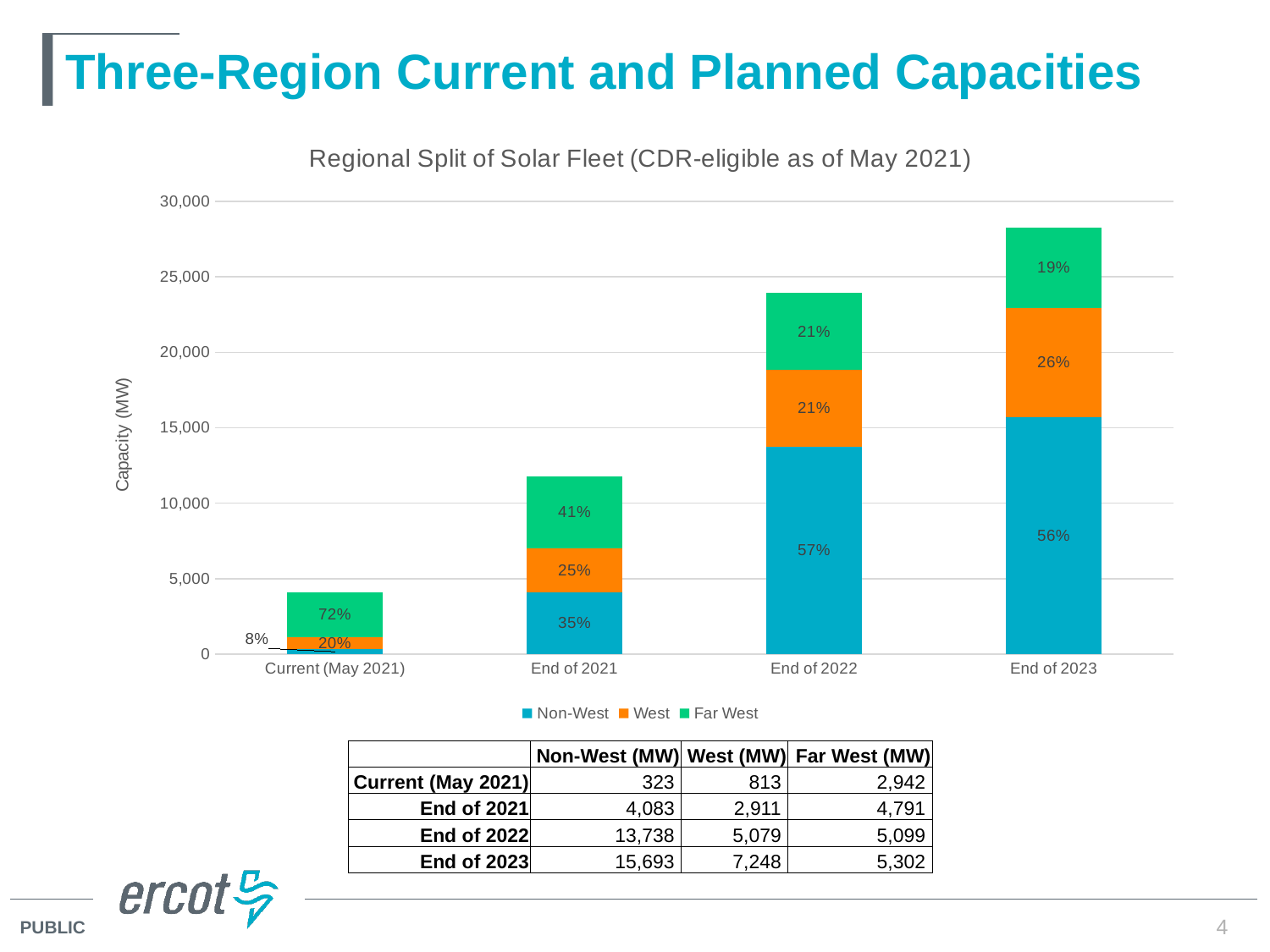
According to the table, what is the Non-West capacity in MW at End of 2022? 13,738 Which category has the tallest stacked bar in the chart? End of 2023 What percentage label is shown for the Non-West segment of the End of 2023 bar? 56% How many series does the chart legend list? 3 What percentage label is shown for the Far West segment of the End of 2021 bar? 41% Is the total height of the End of 2022 bar greater or less than 20,000? greater Does the total stacked capacity rise or fall from Current (May 2021) to End of 2023? Rise How many categories are shown along the x axis of the chart? 4 Using the table values, what is the total capacity in MW across the three regions at End of 2021? 11,785 According to the table, by how many MW does West capacity increase from End of 2022 to End of 2023? 2,169 What kind of chart is shown on the slide? Stacked bar chart What is the title of the chart? Regional Split of Solar Fleet (CDR-eligible as of May 2021)